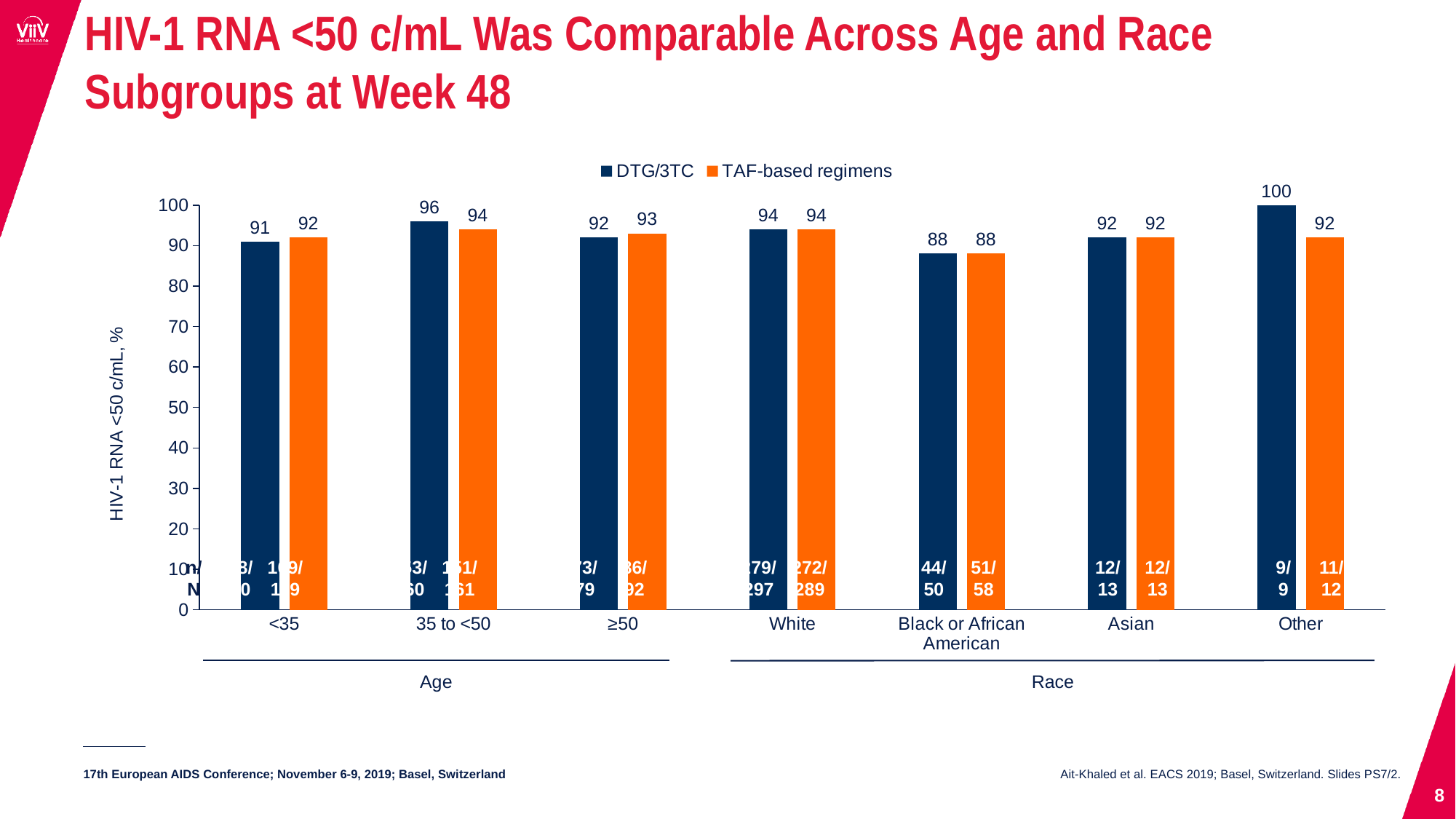
In the 35 to <50 age subgroup, which series has the larger value, DTG/3TC or TAF-based regimens? DTG/3TC What is the label of the y axis? HIV-1 RNA <50 c/mL, % What is the value for DTG/3TC in the Other race subgroup? 100 How many subgroups (categories) are shown on the x axis? 7 Which subgroup has the lowest value for TAF-based regimens? Black or African American What is the value for DTG/3TC in the <35 age subgroup? 91 What is the value for TAF-based regimens in the 35 to <50 age subgroup? 94 What is the difference between the DTG/3TC and TAF-based regimens values in the Other subgroup? 8 What is the value for TAF-based regimens in the Black or African American subgroup? 88 How many series does the legend list? 2 Which subgroup has the highest value for DTG/3TC? Other What kind of chart is shown on the slide? Bar chart